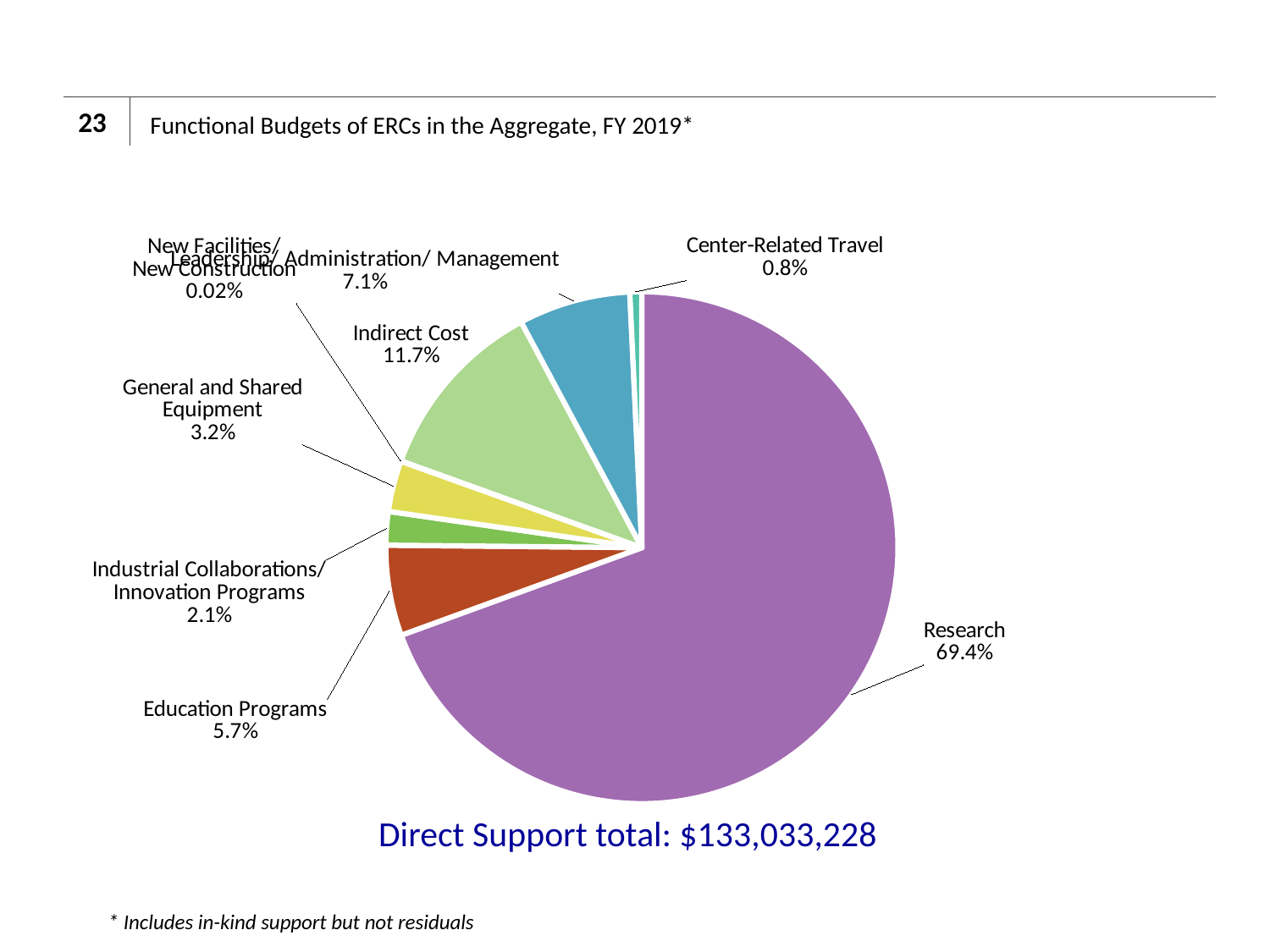
What is the value shown for General and Shared Equipment? 3.2% What kind of chart is shown on the slide? Pie chart What is the value shown for Indirect Cost? 11.7% What is the value shown for Education Programs? 5.7% Which category has the largest slice of the pie? Research What is the difference between the Indirect Cost share and the Leadership/Administration/Management share? 4.6% Which is larger, Leadership/Administration/Management or Education Programs? Leadership/Administration/Management What Direct Support total is stated below the pie chart? $133,033,228 What share of the pie does Research account for? 69.4% What is the value shown for Center-Related Travel? 0.8% Which category has the smallest slice of the pie? New Facilities/New Construction How many categories are shown in the pie chart? 8